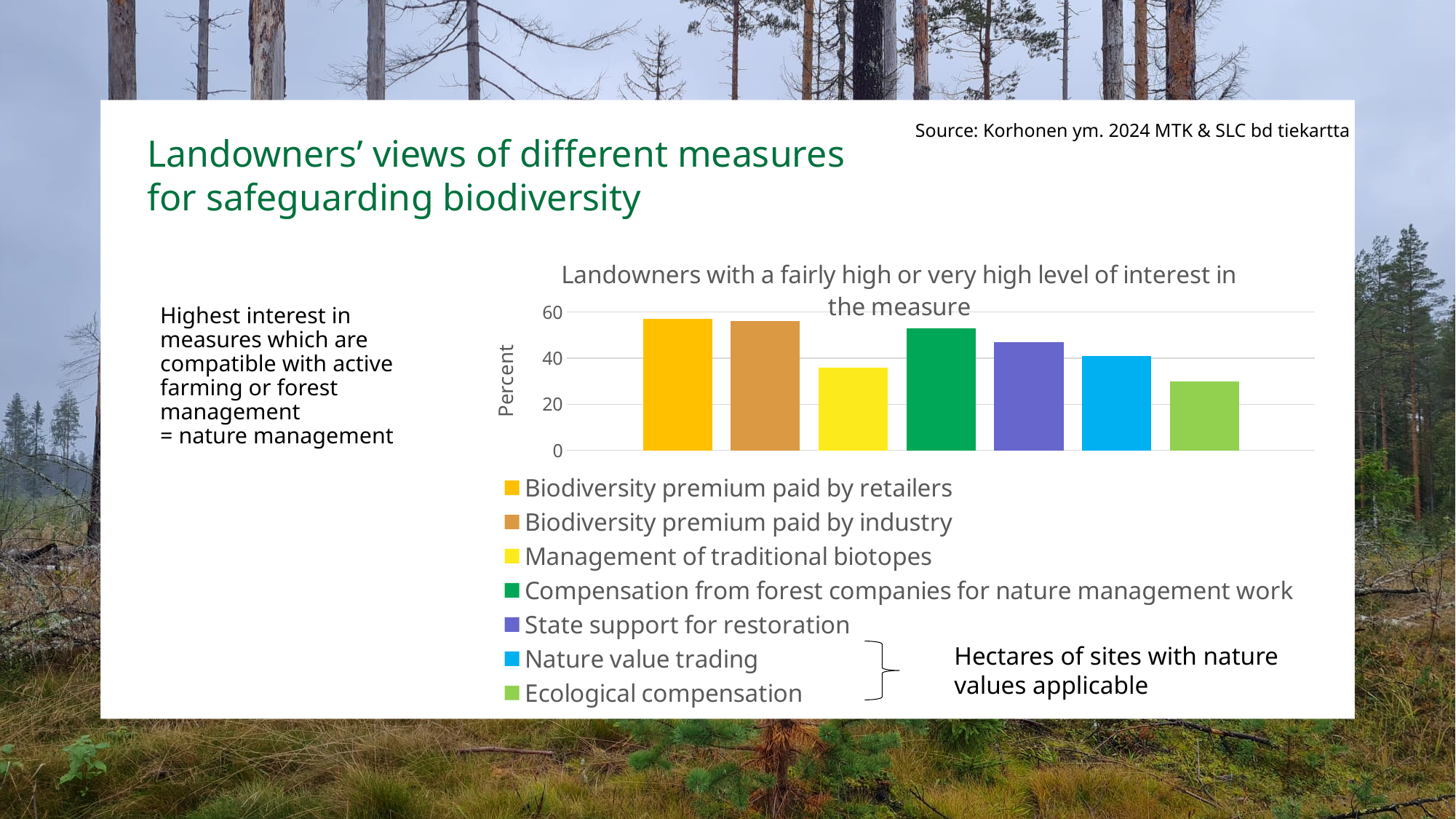
Is the value for Management of traditional biotopes greater or less than 40? less How many bars are plotted in the chart? 7 How many entries does the chart's legend list? 7 Which has a higher value: Compensation from forest companies for nature management work or Management of traditional biotopes? Compensation from forest companies for nature management work What is the label on the vertical axis of the chart? Percent What kind of chart is shown on the slide? Bar chart What is the title of the chart? Landowners with a fairly high or very high level of interest in the measure Is the value for Compensation from forest companies for nature management work greater or less than 40? greater Is the value for Ecological compensation greater or less than 20? greater Which measure has the lowest share of landowners with a fairly high or very high level of interest? Ecological compensation Which has a higher value: State support for restoration or Ecological compensation? State support for restoration